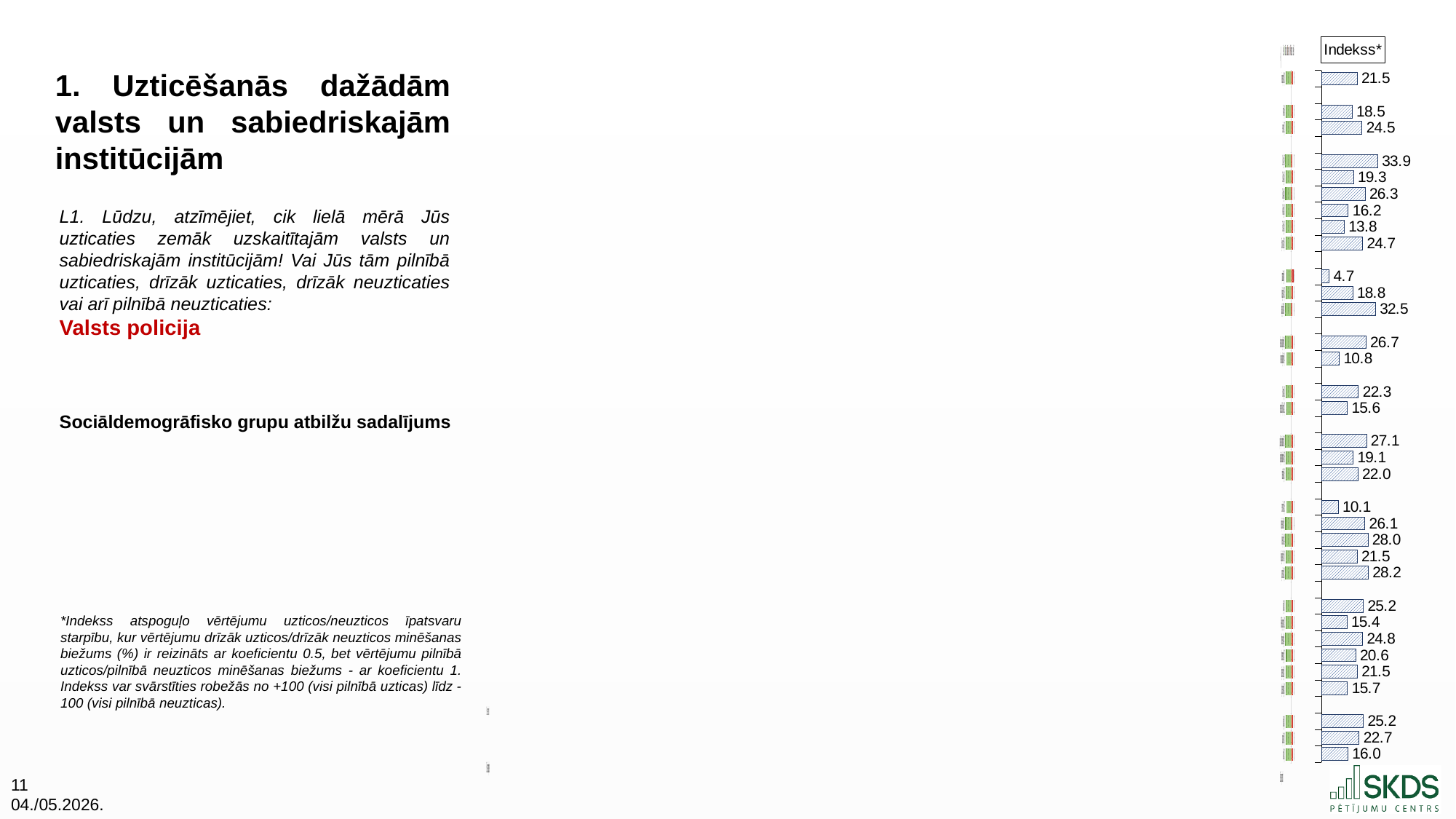
In the "Indekss*" chart, what is the difference between the highest value (33.9) and the lowest value (4.7)? 29.2 In the "Indekss*" chart, which is larger: the value 32.5 or the value 26.7? 32.5 What kind of chart is the "Indekss*" chart on the right of the slide? bar chart In the "Indekss*" chart, what is the highest value shown? 33.9 In the "Indekss*" chart, what is the second-highest value shown? 32.5 In the "Indekss*" chart, what is the lowest value shown? 4.7 In the "Indekss*" chart, what is the value of the bottommost bar? 16.0 In the "Indekss*" chart, what is the value of the topmost bar? 21.5 What is the title shown above the chart on the right of the slide? Indekss* How many bars are plotted in the "Indekss*" chart? 33